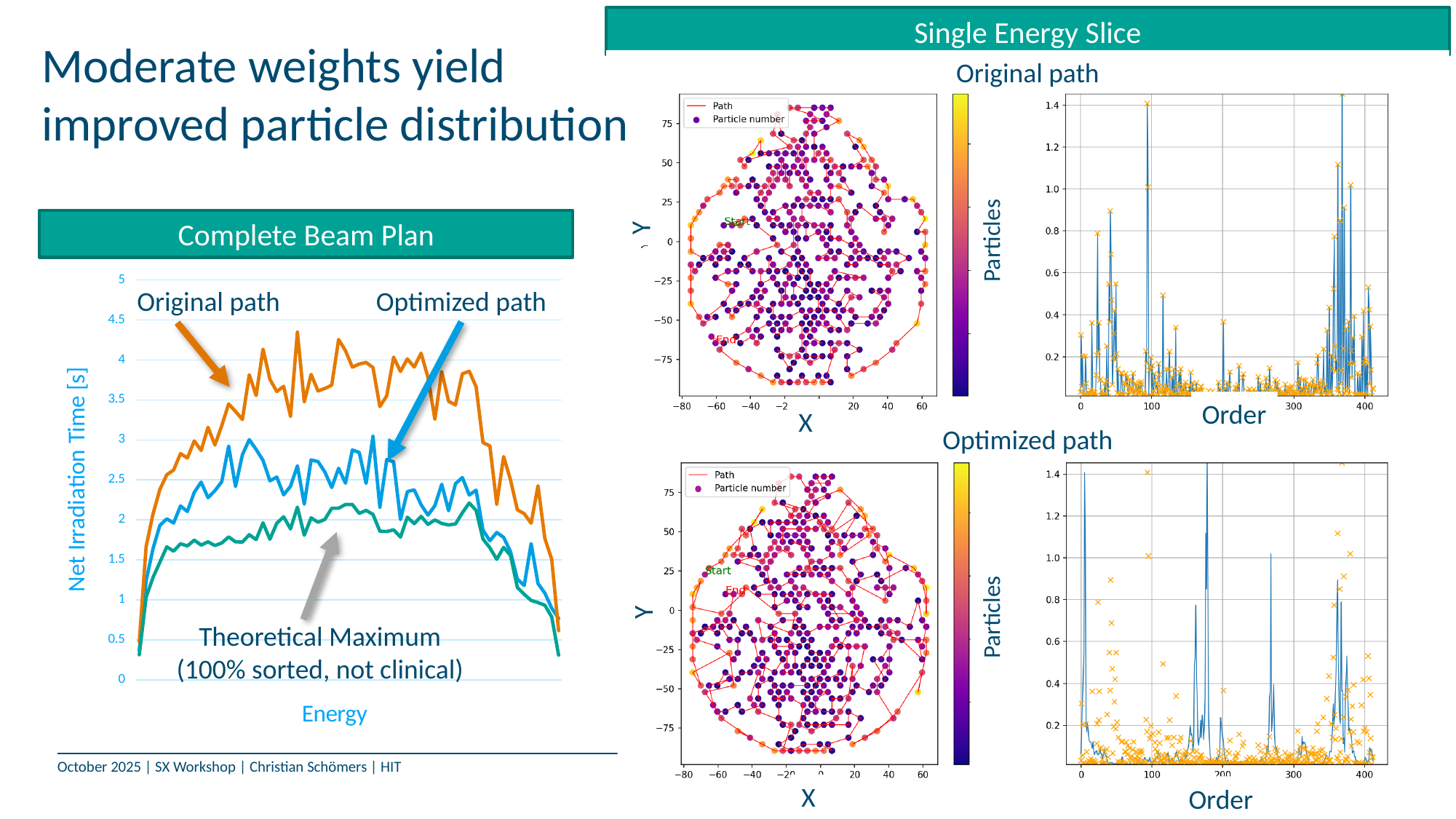
How many entries does the legend of the Original path scatter plot under Single Energy Slice list? 2 In the Complete Beam Plan chart, do the values of the Original path rise or fall toward the highest energies at the right end of the x axis? fall What is the y-axis label of the Complete Beam Plan chart? Net Irradiation Time [s] What is the label on the colour bar next to the Optimized path scatter plot under Single Energy Slice? Particles What is the x-axis label of the Complete Beam Plan chart? Energy In the Complete Beam Plan chart, is the peak value of the Theoretical Maximum greater or less than 2.5? less What kind of chart is the Complete Beam Plan chart? line chart In the Complete Beam Plan chart, is the peak value of the Original path greater or less than 4? greater In the Complete Beam Plan chart, which series reaches the highest net irradiation time? Original path In the Complete Beam Plan chart, which is higher in the middle of the energy range, the Original path or the Optimized path? Original path How many series are plotted in the Complete Beam Plan chart? 3 In the Complete Beam Plan chart, which series has the lowest net irradiation time across most of the energy range? Theoretical Maximum